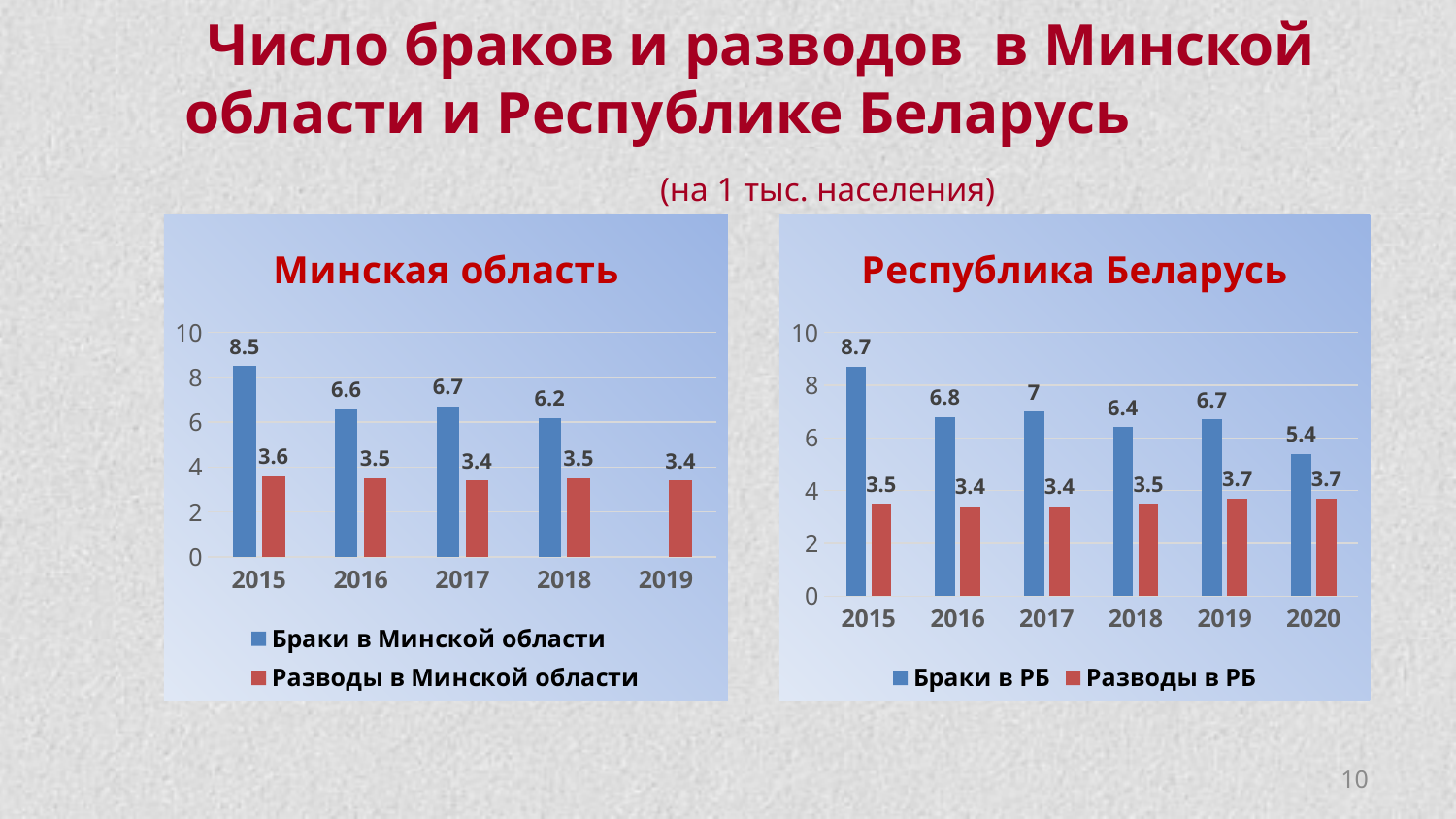
In the 'Республика Беларусь' chart, is the value for 'Браки в РБ' in 2017 larger than the value in 2018? Yes, 2017 (7) is larger than 2018 (6.4) In the 'Минская область' chart, which year has the highest value for 'Браки в Минской области'? 2015 In the 'Минская область' chart, what is the value for 'Разводы в Минской области' in 2019? 3.4 What kind of chart is the 'Минская область' chart? Bar chart In the 'Минская область' chart, how many series does the legend list? 2 In the 'Минская область' chart, what is the value for 'Браки в Минской области' in 2015? 8.5 In the 'Республика Беларусь' chart, what is the difference between 'Браки в РБ' in 2015 and 2020? 3.3 In the 'Республика Беларусь' chart, what is the value for 'Браки в РБ' in 2020? 5.4 In the 'Республика Беларусь' chart, how many years are shown on the x axis? 6 In the 'Республика Беларусь' chart, what is the value for 'Разводы в РБ' in 2019? 3.7 In the 'Республика Беларусь' chart, which year has the lowest value for 'Браки в РБ'? 2020 In the 'Минская область' chart, what is the difference between 'Браки в Минской области' and 'Разводы в Минской области' in 2018? 2.7